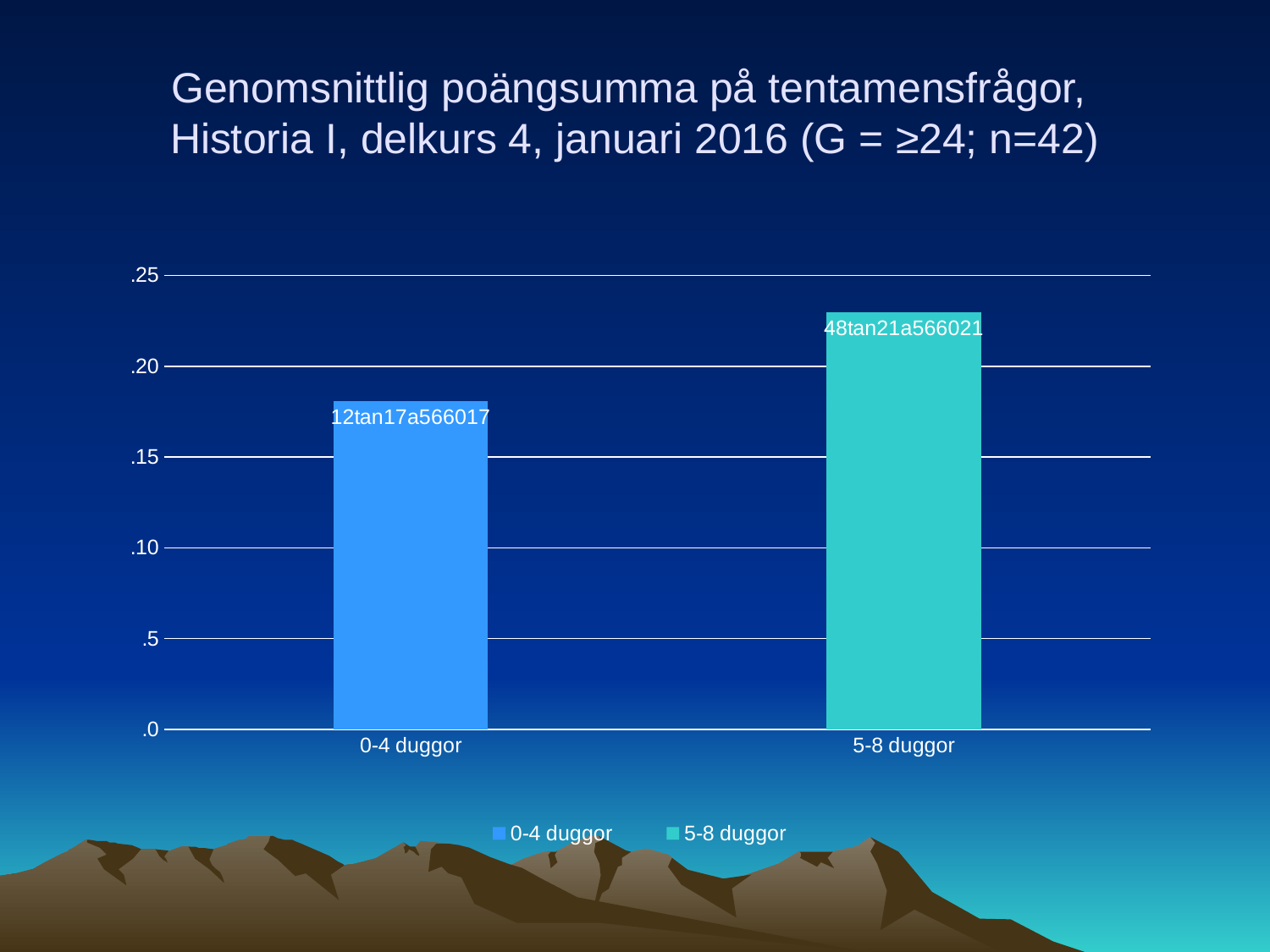
Is the value for 5-8 duggor greater or less than .25? less Which category has the highest bar? 5-8 duggor What are the two entries listed in the chart legend? 0-4 duggor and 5-8 duggor What kind of chart is shown on the slide? bar chart What is the highest value shown on the vertical axis of the chart? .25 Is the value for 0-4 duggor greater or less than .15? greater Which is larger, the value for 0-4 duggor or the value for 5-8 duggor? 5-8 duggor Is the value for 5-8 duggor greater or less than .20? greater How many categories are shown on the x axis of the chart? 2 Which category has the lowest bar? 0-4 duggor How many series does the legend list? 2